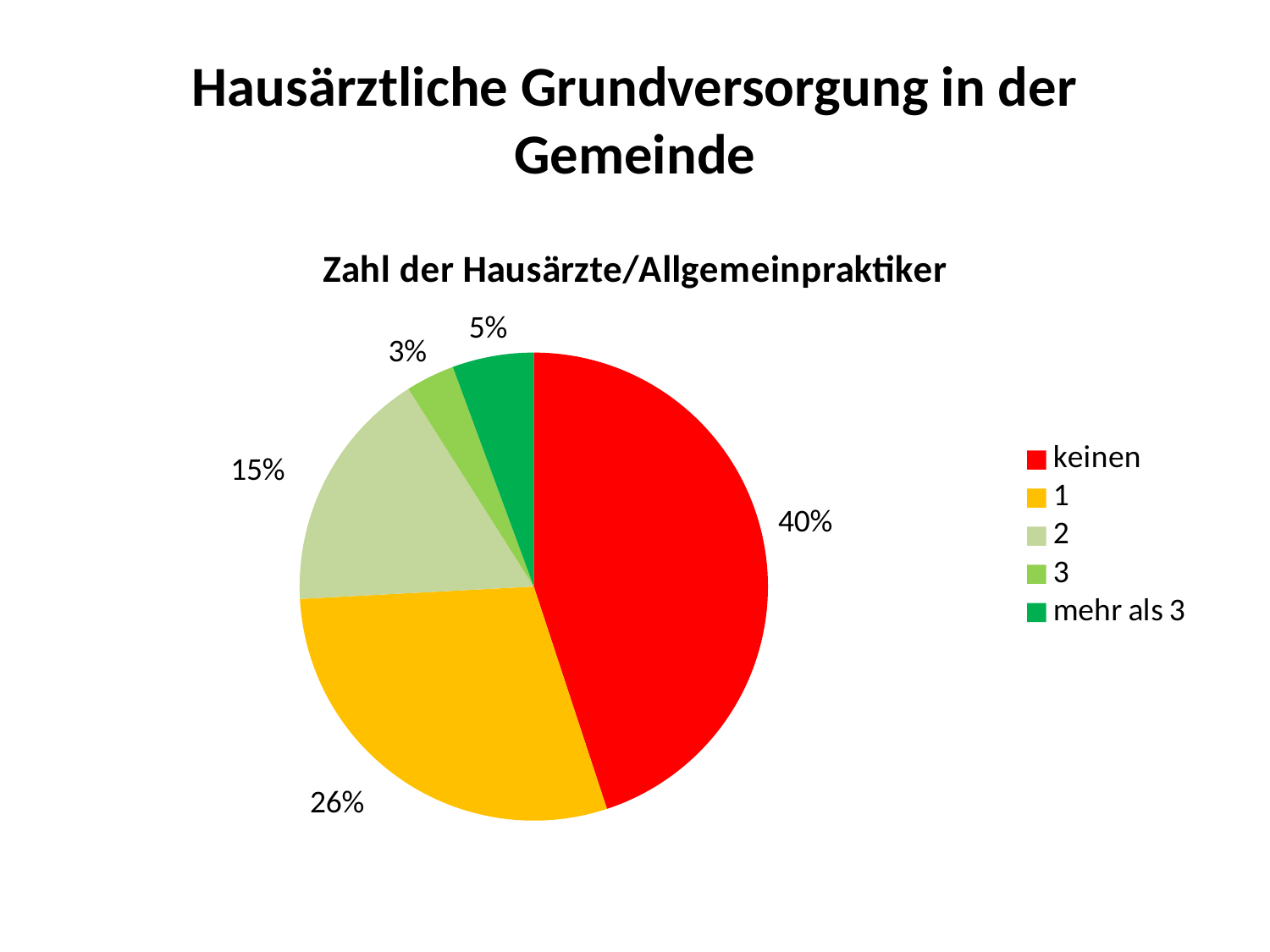
What is the title of the chart? Zahl der Hausärzte/Allgemeinpraktiker What is the difference between the 'keinen' slice and the '1' slice? 14% Which is larger, the slice for '2' or the slice for 'mehr als 3'? 2 What is the value shown for 'mehr als 3'? 5% Which category has the smallest slice of the pie? 3 What is the value shown for the category '1'? 26% How many categories does the legend list? 5 What is the value shown for the category '2'? 15% Which category has the largest slice of the pie? keinen What share of the pie does the 'keinen' slice represent? 40% What is the value shown for the category '3'? 3% What kind of chart is shown on the slide? Pie chart